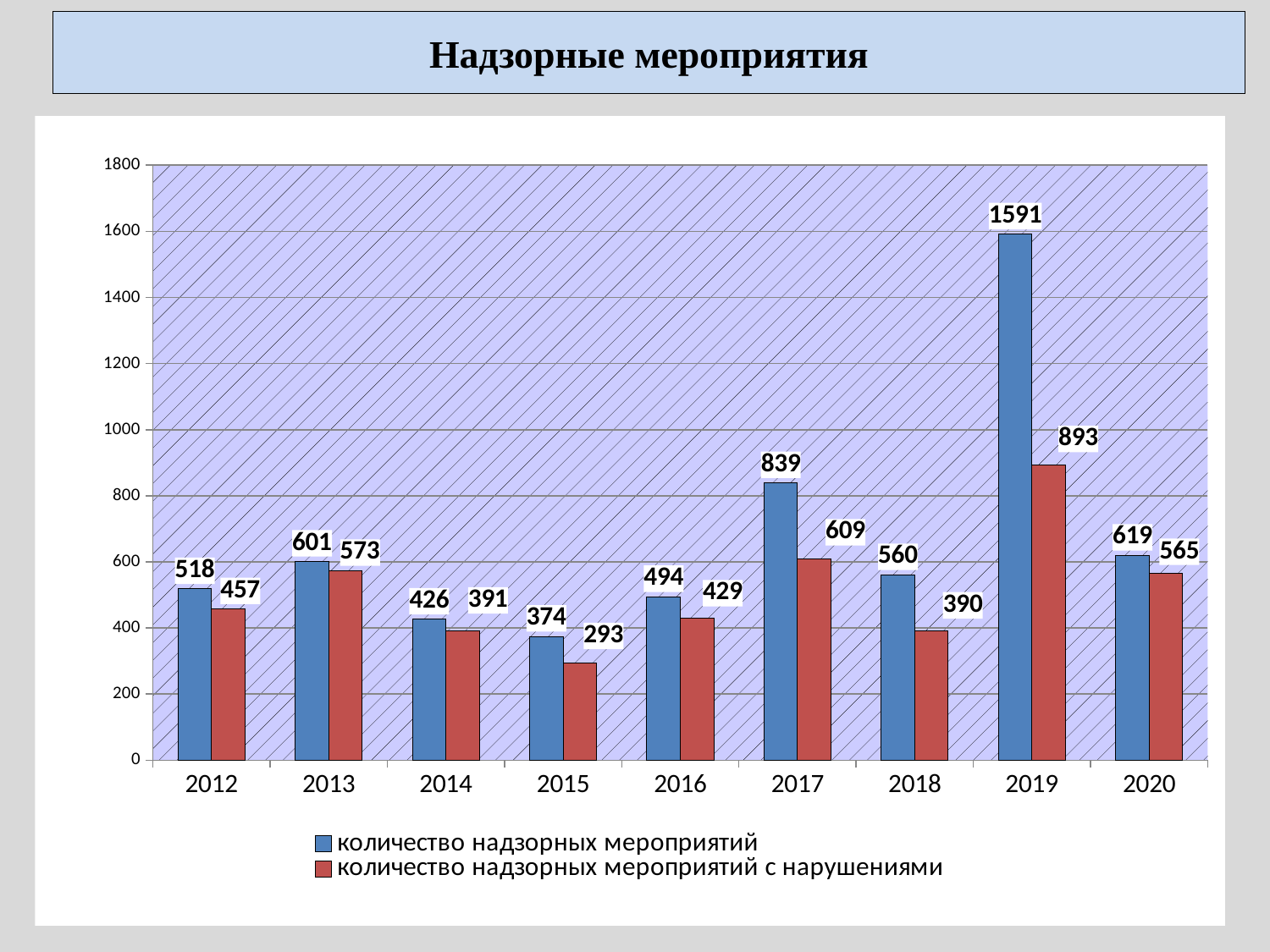
What is the difference between 'количество надзорных мероприятий' and 'количество надзорных мероприятий с нарушениями' in 2019? 698 How many years are shown on the x axis? 9 What is the value of 'количество надзорных мероприятий с нарушениями' for 2015? 293 What is the difference between 'количество надзорных мероприятий' in 2018 and 'количество надзорных мероприятий с нарушениями' in 2018? 170 Is the value for 'количество надзорных мероприятий' in 2017 greater or less than 800? greater Which year has the highest value for 'количество надзорных мероприятий'? 2019 Which year has the lowest value for 'количество надзорных мероприятий с нарушениями'? 2015 What is the value of 'количество надзорных мероприятий' for 2019? 1591 How many series does the legend list? 2 What kind of chart is shown on the slide? bar chart Which is larger: 'количество надзорных мероприятий с нарушениями' in 2013 or in 2020? 2013 What is the value of 'количество надзорных мероприятий' for 2017? 839